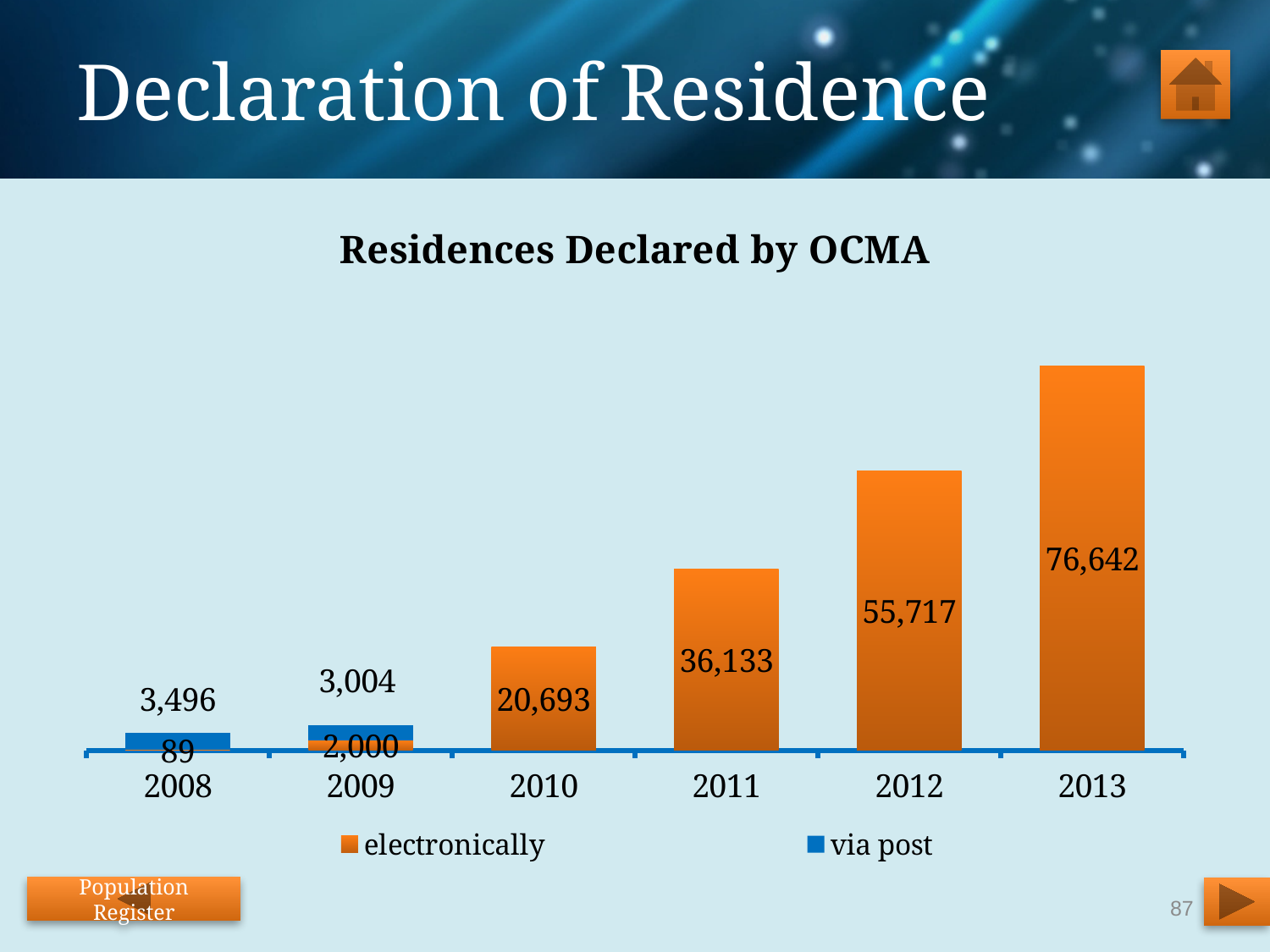
Which year has the lowest value for 'electronically'? 2008 What is the difference between the 'electronically' values for 2013 and 2012? 20,925 In 2008, which is larger: 'electronically' or 'via post'? via post How many years are shown on the x axis? 6 What is the difference between the 'via post' values for 2008 and 2009? 492 How many series does the legend list? 2 What is the value for 'electronically' in 2011? 36,133 What is the value for 'electronically' in 2009? 2,000 What kind of chart is shown on the slide? bar chart What is the value for 'electronically' in 2013? 76,642 What is the value for 'via post' in 2008? 3,496 Which year has the highest value for 'electronically'? 2013